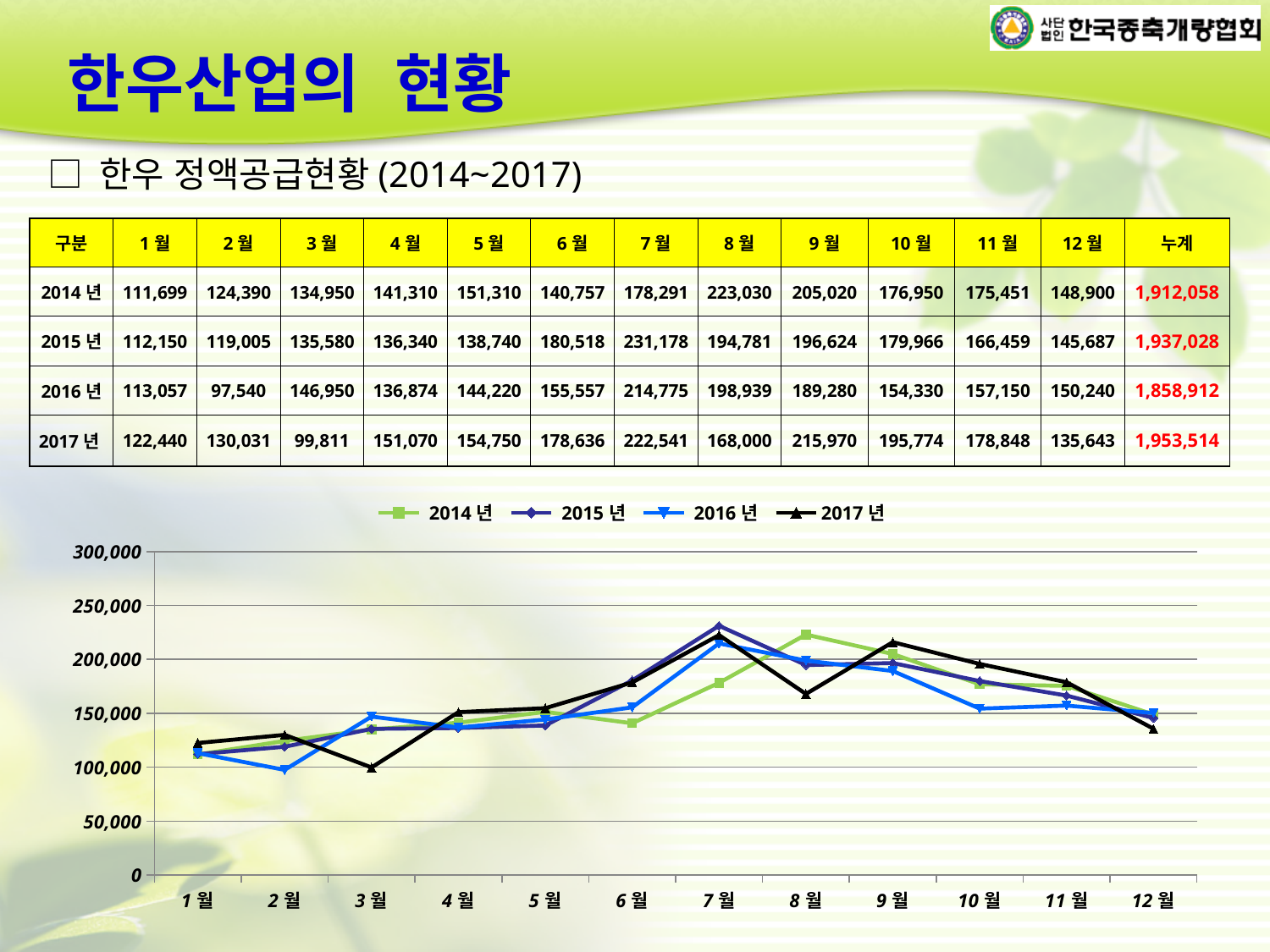
What kind of chart is shown on the slide? line chart How many months are plotted along the x axis of the chart? 12 What is the 누계 (cumulative total) for 2017년? 1,953,514 What colour is the line for the 2017년 series? black Is the value for 2017년 in 8월 greater or less than 200,000? less In 7월, which series has the larger value, 2014년 or 2015년? 2015년 How many series does the chart legend list? 4 What is the difference between the 2014년 and 2017년 values in 8월? 55,030 In which month does the 2016년 series have its lowest value? 2월 What is the value for 2017년 in 7월? 222,541 Does the 2014년 series rise or fall from 1월 to 5월? rise In which month does the 2015년 series reach its highest value? 7월